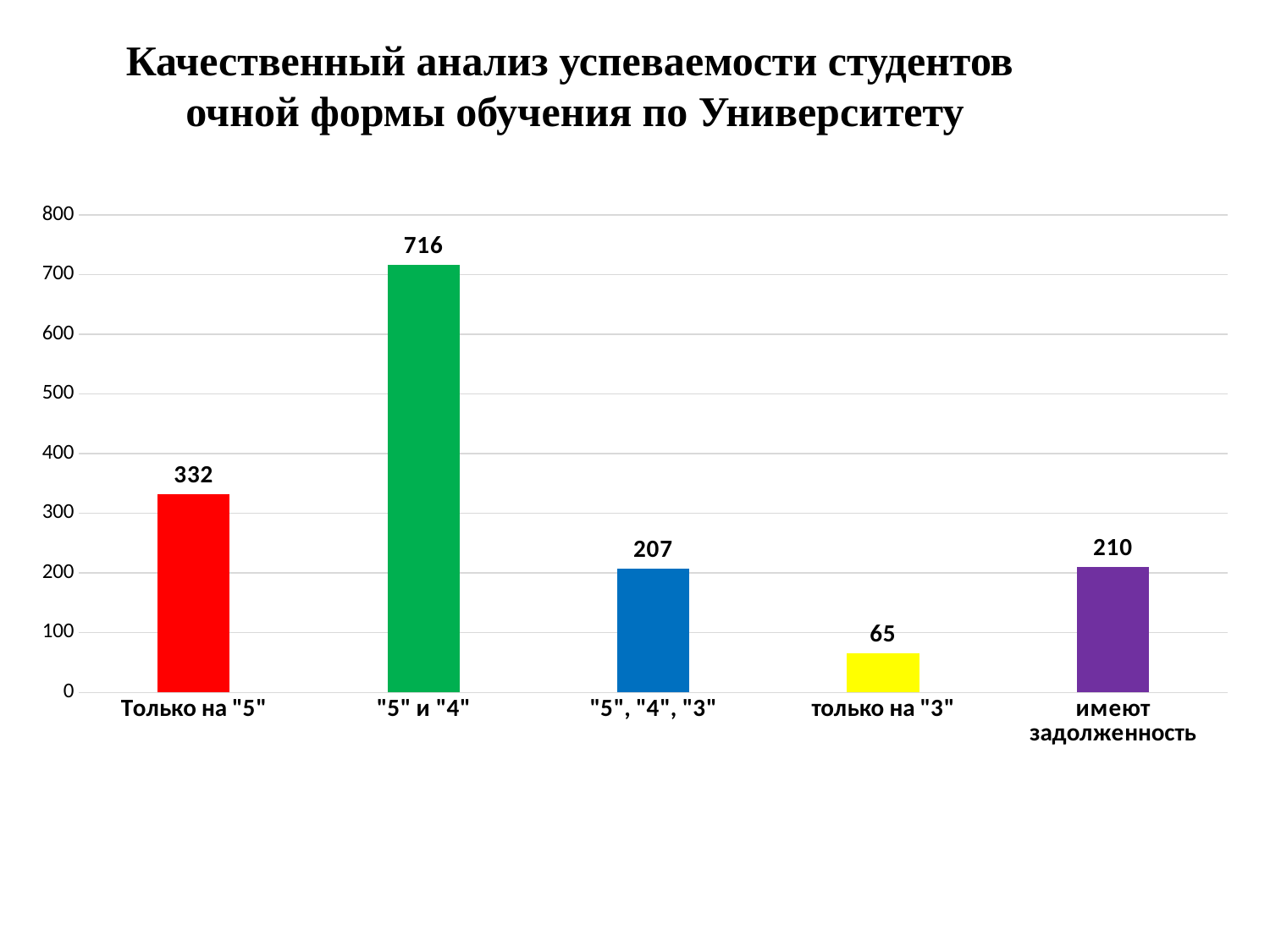
What is the value for the category "5" и "4"? 716 What colour is the bar for "5" и "4"? green Which category has the highest value? "5" и "4" What is the value for the category имеют задолженность? 210 What is the value for the category Только на "5"? 332 What is the value for the category только на "3"? 65 What is the difference between the values for "5" и "4" and Только на "5"? 384 Which category has the lowest value? только на "3" Which is larger: the value for "5", "4", "3" or the value for имеют задолженность? имеют задолженность How many categories are shown on the x axis? 5 What kind of chart is shown on the slide? bar chart Is the value for Только на "5" greater or less than 300? greater